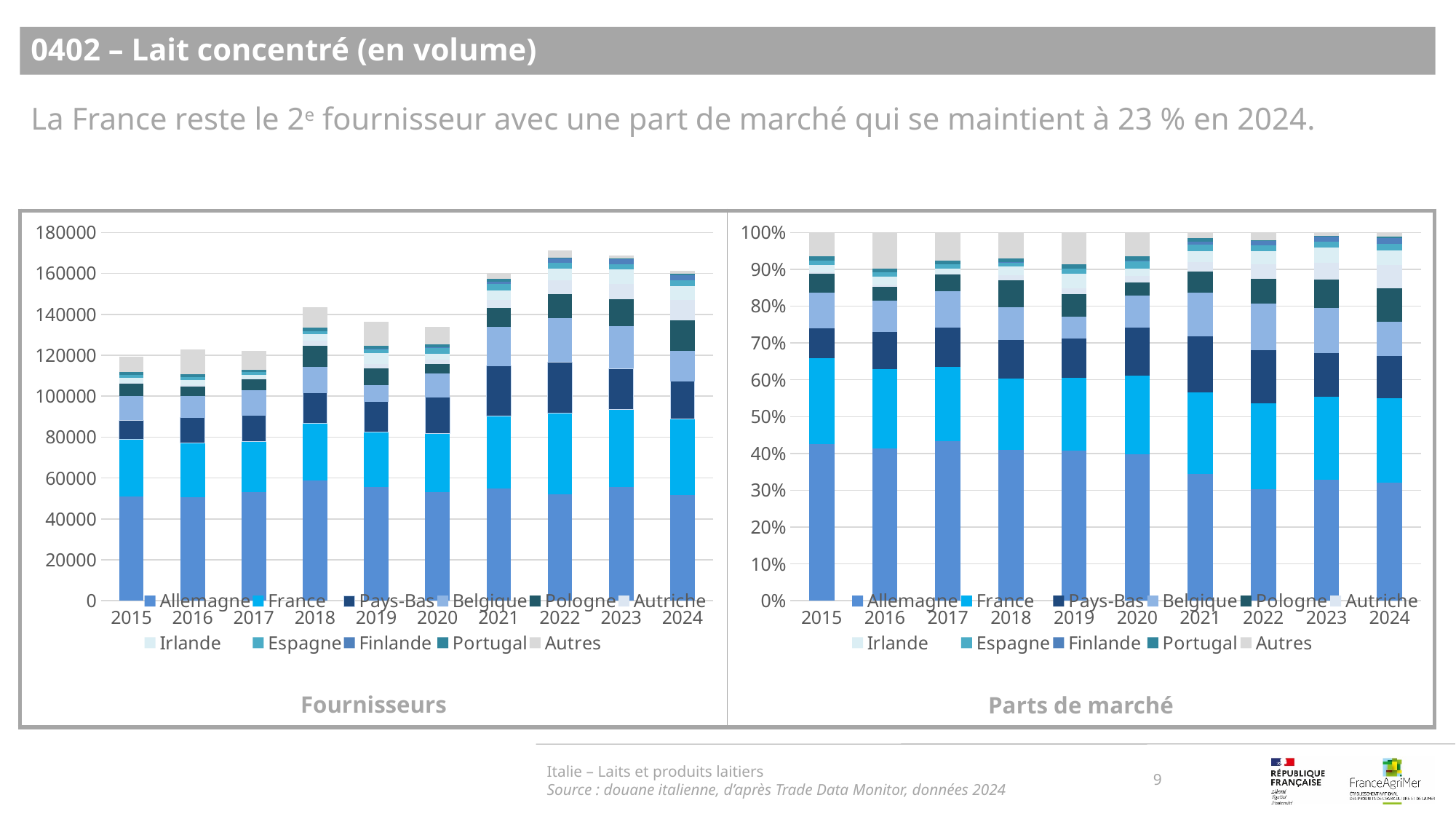
In the 'Parts de marché' chart, is the Allemagne share in 2015 greater or less than 40%? greater In the 'Parts de marché' chart, is the Allemagne share in 2024 greater or less than 40%? less How many series does the legend of the 'Fournisseurs' chart list? 11 In the 'Fournisseurs' chart, is the total bar for 2015 greater or less than 100000? greater In the 'Parts de marché' chart, does the Allemagne share rise or fall from 2015 to 2024? fall How many years are shown on the x axis of the 'Parts de marché' chart? 10 What kind of chart is the 'Fournisseurs' chart on the left? stacked bar chart In the 'Fournisseurs' chart, is the Allemagne segment larger in 2018 or in 2015? 2018 Which series is listed first in the legend of the 'Fournisseurs' chart? Allemagne What is the title of the chart on the right of the slide? Parts de marché